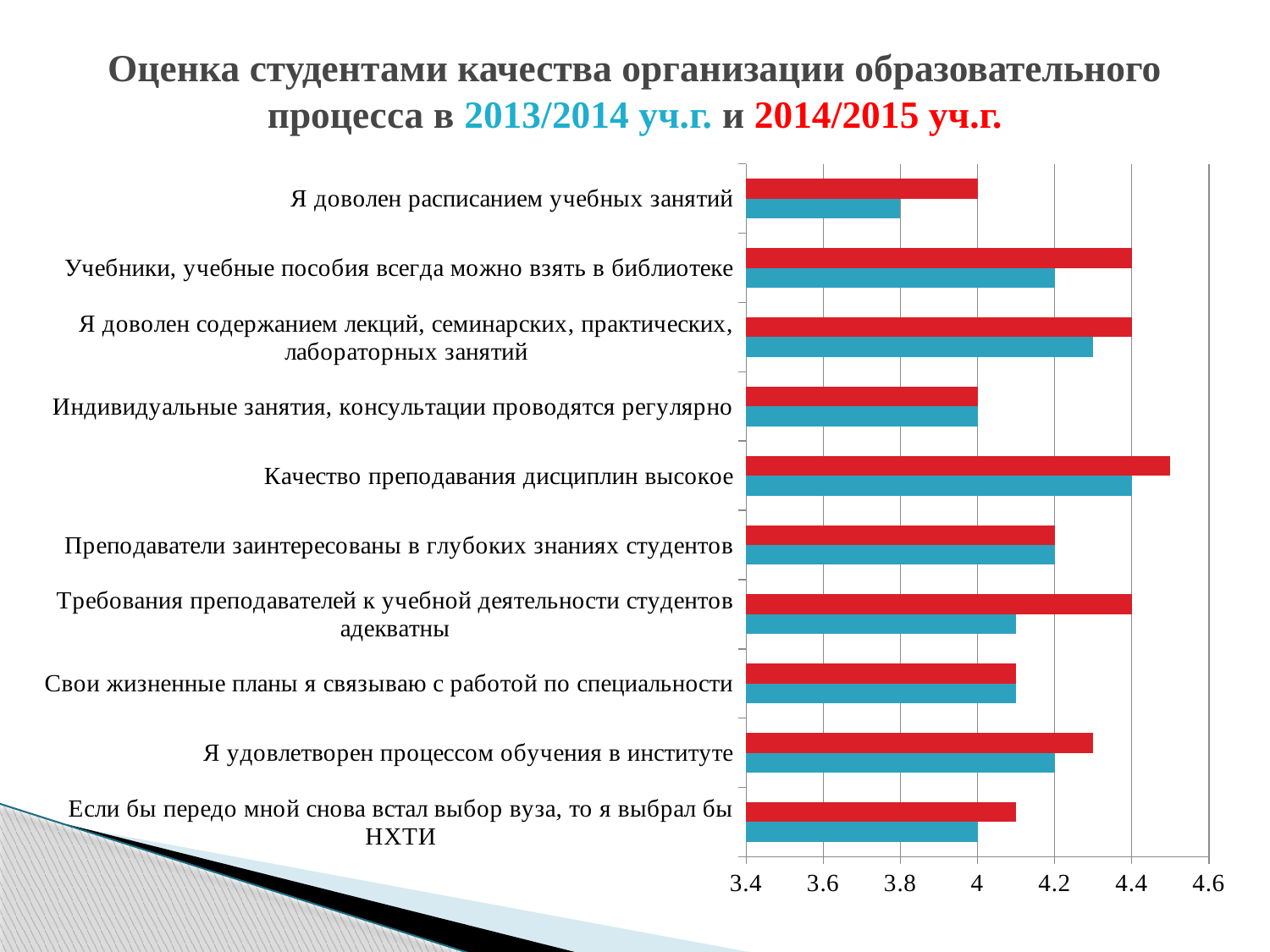
Which statement has the longest bar on the chart? Качество преподавания дисциплин высокое What is the value of the red (2014/2015) bar for "Я доволен расписанием учебных занятий"? 4 What kind of chart is shown on the slide? bar chart Is the red (2014/2015) value for "Качество преподавания дисциплин высокое" greater or less than 4.4? greater What is the value of the blue (2013/2014) bar for "Я доволен расписанием учебных занятий"? 3.8 What is the value of the blue (2013/2014) bar for "Качество преподавания дисциплин высокое"? 4.4 Which statement has the shortest bar on the chart? Я доволен расписанием учебных занятий How many series (academic years) does the chart compare? 2 How many statements (categories) are listed on the chart? 10 For "Я удовлетворен процессом обучения в институте", which bar is longer, the red (2014/2015) or the blue (2013/2014)? red (2014/2015) Is the blue (2013/2014) value for "Требования преподавателей к учебной деятельности студентов адекватны" greater or less than 4.2? less What is the value of the red (2014/2015) bar for "Учебники, учебные пособия всегда можно взять в библиотеке"? 4.4